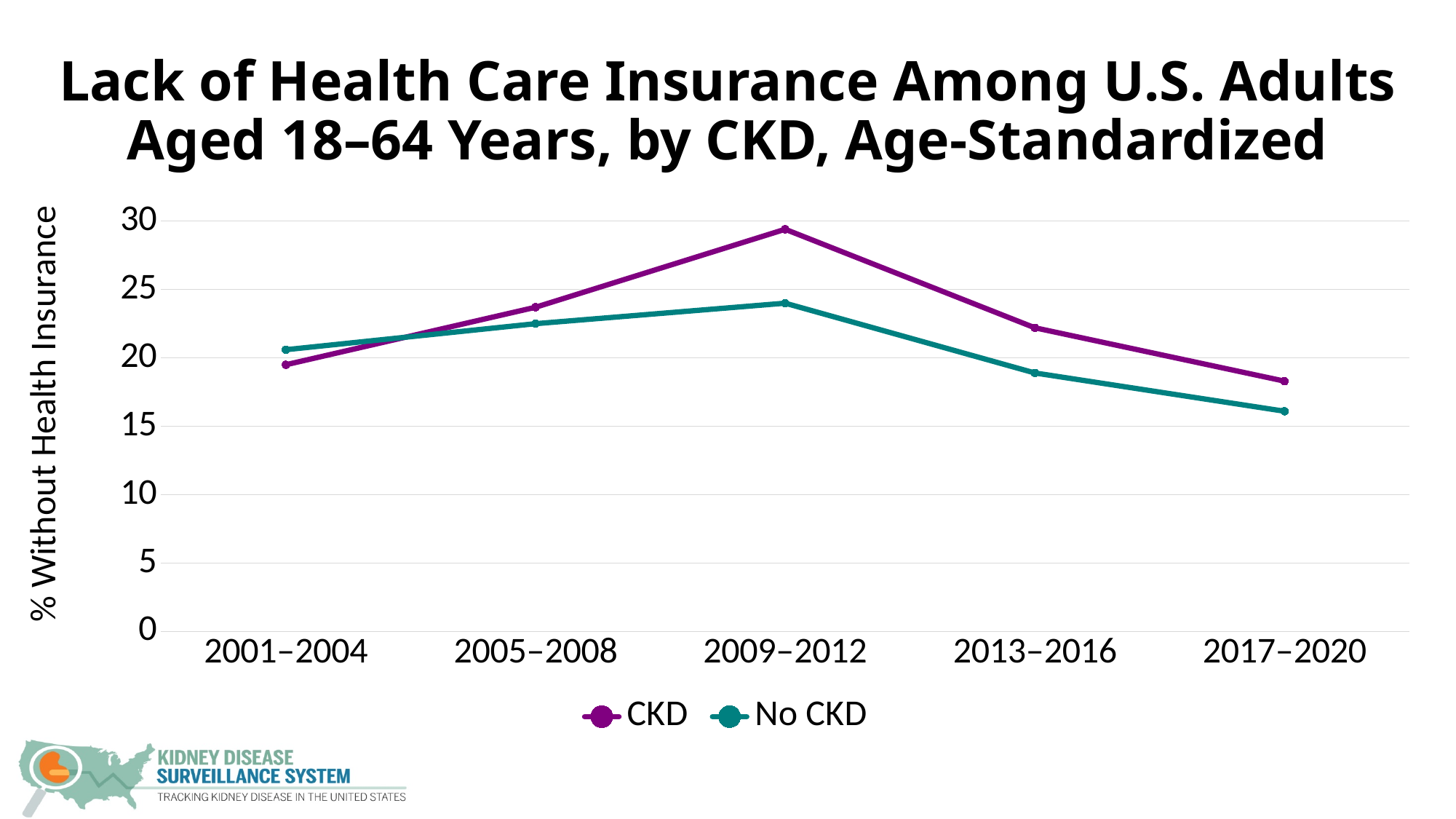
Is the value for No CKD in 2017–2020 greater or less than 20? less In which period does the CKD series reach its highest value? 2009–2012 Is the value for CKD in 2009–2012 greater or less than 25? greater What kind of chart is shown on the slide? line chart Which series is shown in purple? CKD How many time periods are shown on the x axis? 5 Which series has the larger value in 2001–2004, CKD or No CKD? No CKD How many series does the legend list? 2 Does the CKD series rise or fall from 2009–2012 to 2017–2020? fall What is the y-axis label? % Without Health Insurance Which series has the larger value in 2013–2016, CKD or No CKD? CKD In which period does the No CKD series reach its lowest value? 2017–2020